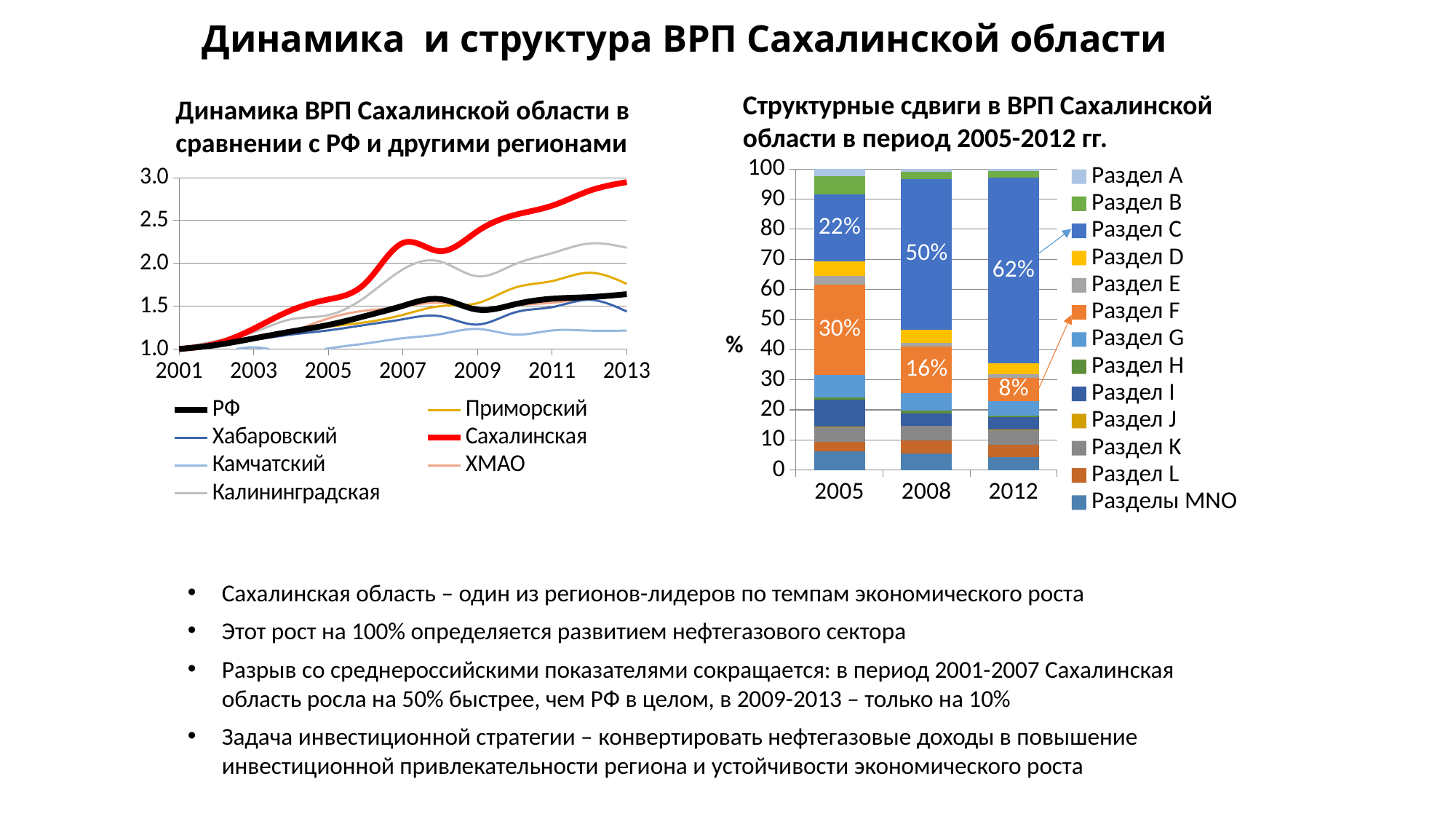
On the left chart, what type of chart is used to show the dynamics of GRP? line chart On the right chart (Структурные сдвиги), by how many percentage points did the share of Раздел C grow from 2005 to 2012? 40 On the right chart (Структурные сдвиги), what is the share of Раздел C in 2012? 62% On the right chart (Структурные сдвиги), how many years are shown on the x axis? 3 On the left chart, which region's line is the lowest in 2013? Камчатский On the left chart, is the value for Сахалинская in 2013 greater or less than 2.5? greater On the right chart (Структурные сдвиги), which is larger in 2008: the share of Раздел C or Раздел F? Раздел C On the left chart, how many series does the legend list? 7 On the left chart, is the value for РФ in 2013 greater or less than 2.0? less On the left chart, does the Сахалинская line rise or fall from 2001 to 2013? rises On the left chart, which region's line is the highest in 2013? Сахалинская On the right chart (Структурные сдвиги), what is the share of Раздел F in 2005? 30%